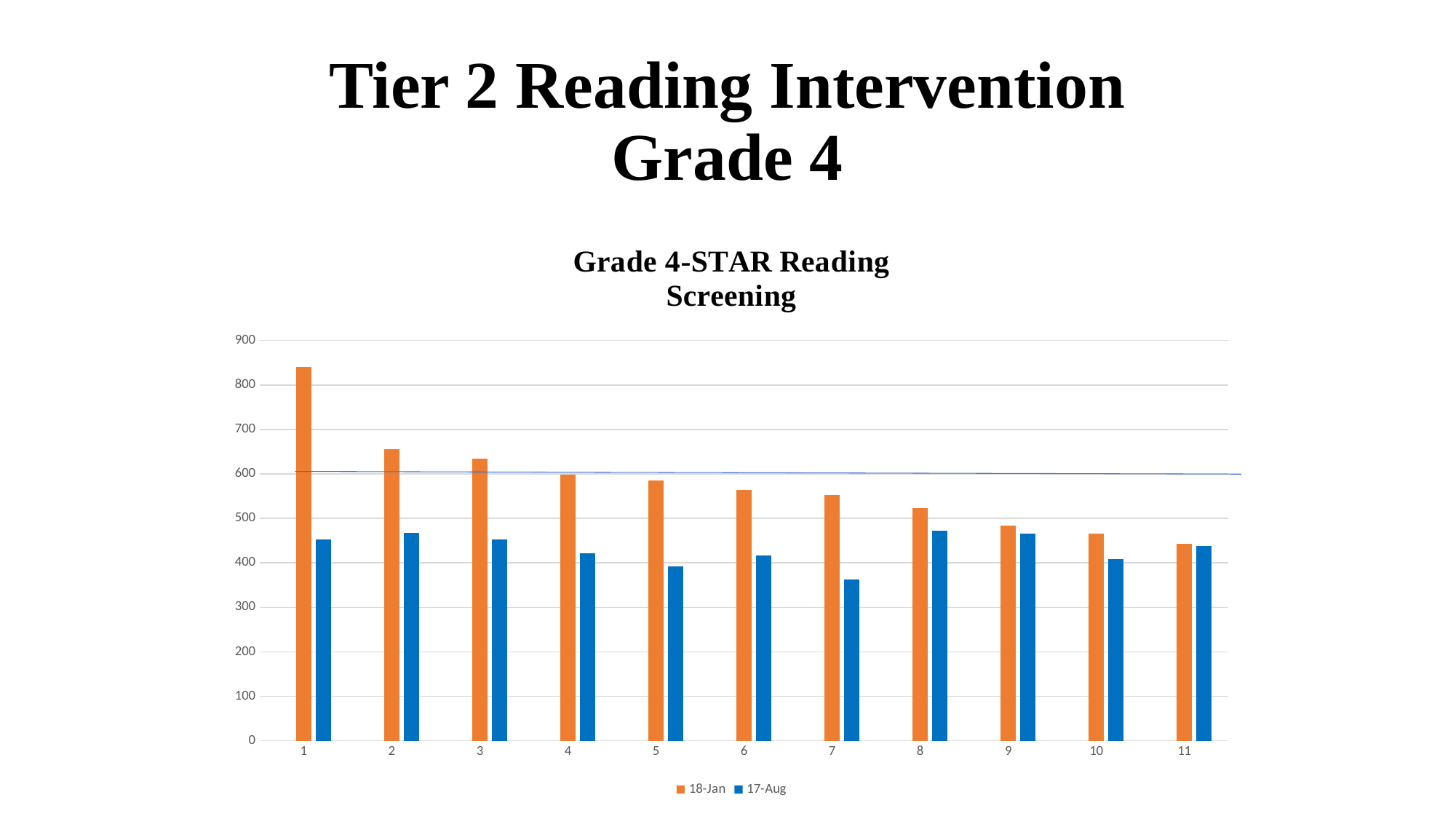
Which category has the lowest 17-Aug value? 7 For category 1, which series has the larger value, 18-Jan or 17-Aug? 18-Jan Is the 17-Aug value for category 7 greater or less than 400? less How many categories are shown along the x axis? 11 Is the 18-Jan value for category 1 greater or less than 800? greater How many series does the legend list? 2 Is the 18-Jan value for category 2 greater or less than 600? greater Which category has the lowest 18-Jan value? 11 What kind of chart is shown on the slide? Bar chart Which category has the highest 18-Jan value? 1 Do the 18-Jan values rise or fall from category 1 to category 11? fall What is the title of the chart? Grade 4-STAR Reading Screening